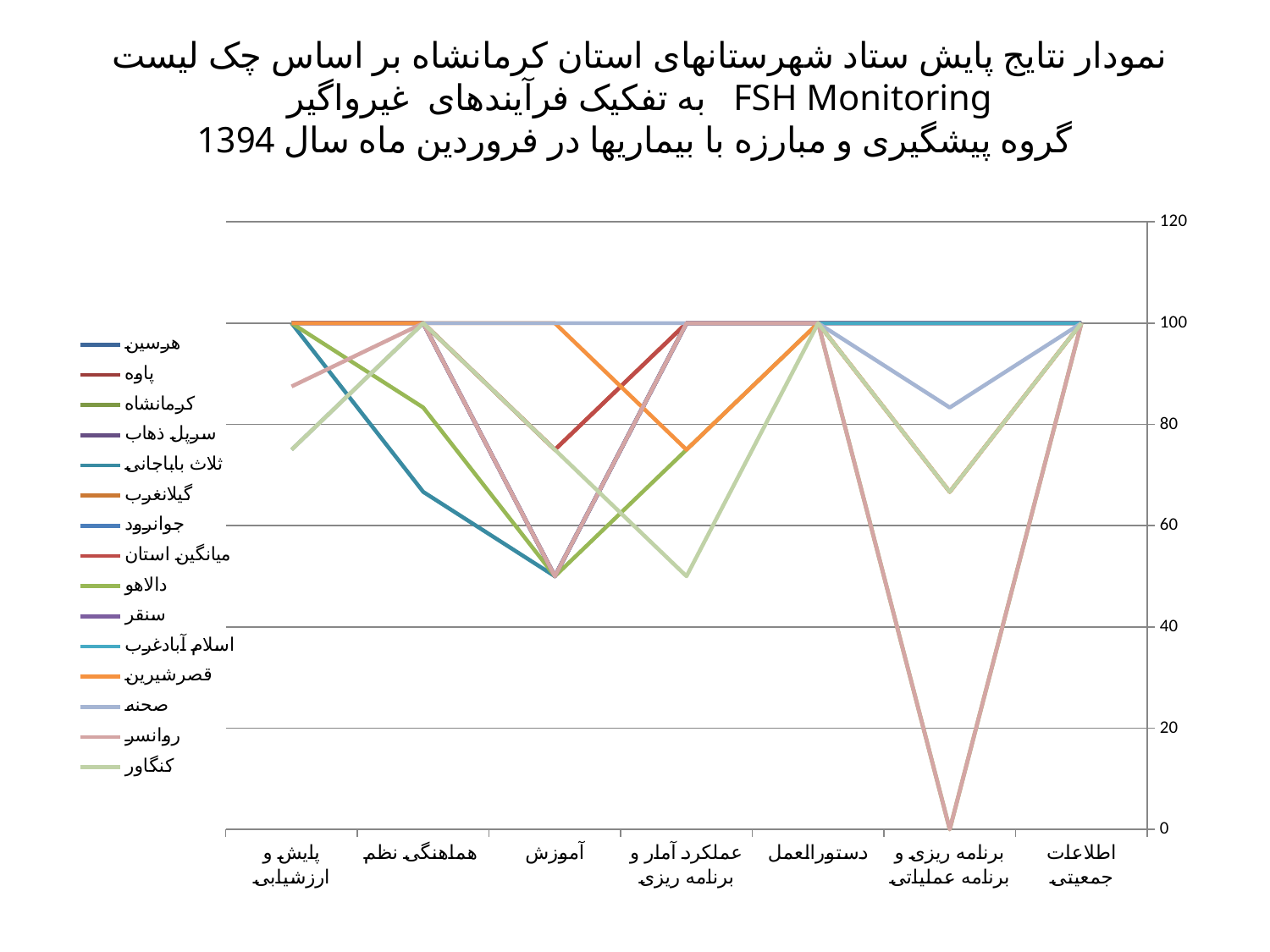
What value do all the series share at اطلاعات جمعیتی? 100 Does the value for روانسر rise or fall from دستورالعمل to برنامه ریزی و برنامه عملیاتی? fall What kind of chart is shown on the slide? line chart Which is the first series listed in the legend? هرسین How many categories are shown along the x axis? 7 At which category does the lowest value on the whole chart occur? برنامه ریزی و برنامه عملیاتی What is the highest value shown on the y axis? 120 Is the value for صحنه at برنامه ریزی و برنامه عملیاتی greater or less than 60? greater Is the value for روانسر at برنامه ریزی و برنامه عملیاتی greater or less than 20? less What is the value for روانسر at برنامه ریزی و برنامه عملیاتی? 0 Is the value for کنگاور at عملکرد آمار و برنامه ریزی greater or less than 60? less How many series does the legend list? 15